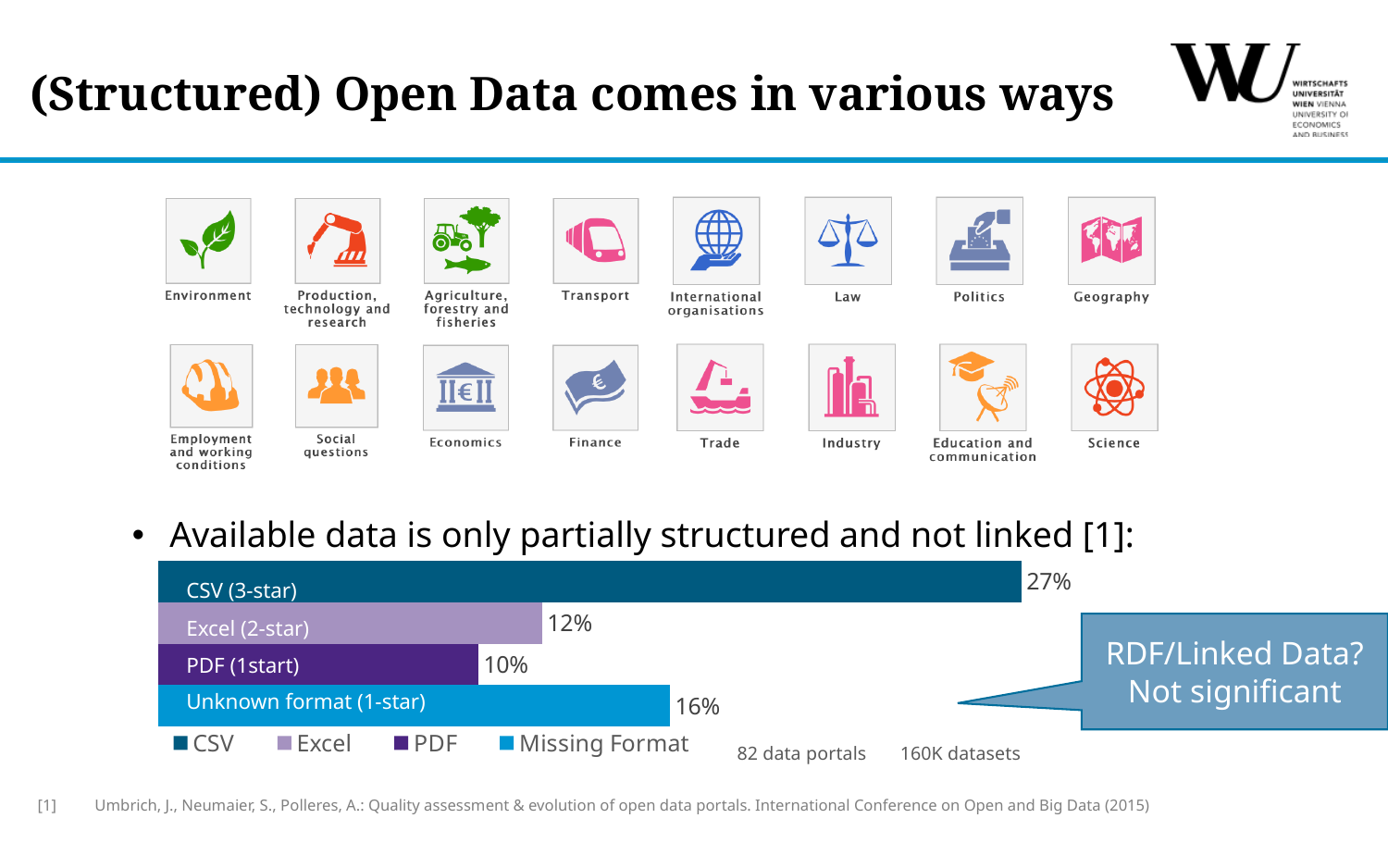
What is the value shown for Unknown format (1-star)? 16% What is the difference between the values for CSV (3-star) and Unknown format (1-star)? 11% What kind of chart is shown on the slide? Bar chart How many bars are plotted in the chart? 4 What is the difference between the values for Excel (2-star) and PDF (1start)? 2% What is the value shown for Excel (2-star)? 12% What is the value shown for CSV (3-star)? 27% How many entries does the chart legend list? 4 Which format has the lowest value in the chart? PDF (1start) What is the value shown for PDF (1start)? 10% Which format has the highest value in the chart? CSV (3-star) Which is larger, the value for Excel (2-star) or the value for Unknown format (1-star)? Unknown format (1-star)